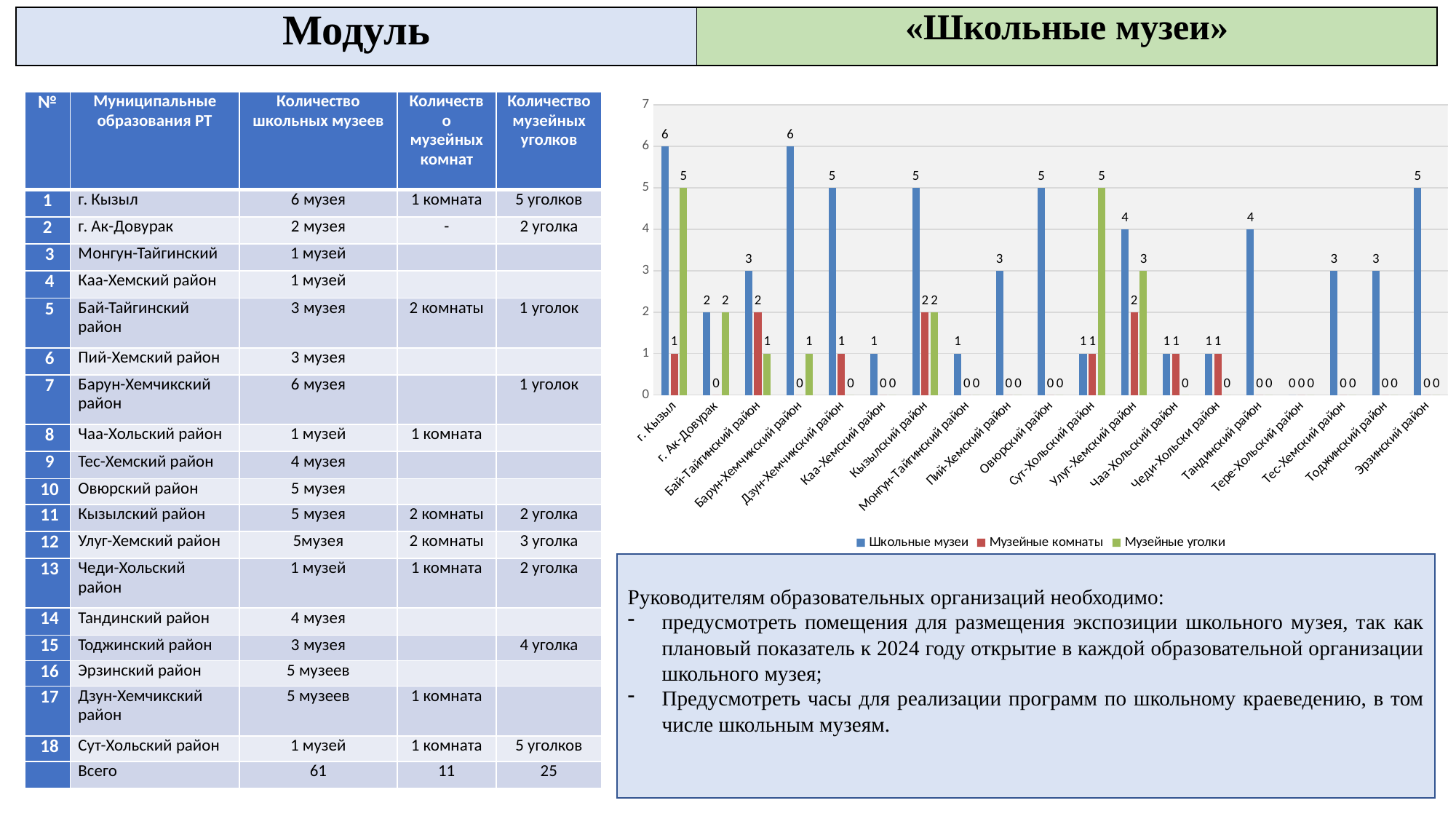
What is the sum of the three series values for Улуг-Хемский район in the chart? 9 What is the value of Школьные музеи for Эрзинский район in the chart? 5 What is the value of Музейные уголки for Сут-Хольский район in the chart? 5 How many series does the chart legend list? 3 What kind of chart is shown on the slide? bar chart In the chart, what is the difference between Школьные музеи and Музейные уголки for г. Кызыл? 1 In the chart, which has more Школьные музеи: Тандинский район or Тес-Хемский район? Тандинский район What colour represents Музейные уголки in the chart legend? green What is the value of Музейные комнаты for Бай-Тайгинский район in the chart? 2 How many municipalities are shown along the x axis of the chart? 19 In the chart, which has more Музейные уголки: Улуг-Хемский район or Кызылский район? Улуг-Хемский район What is the value of Школьные музеи for Улуг-Хемский район in the chart? 4